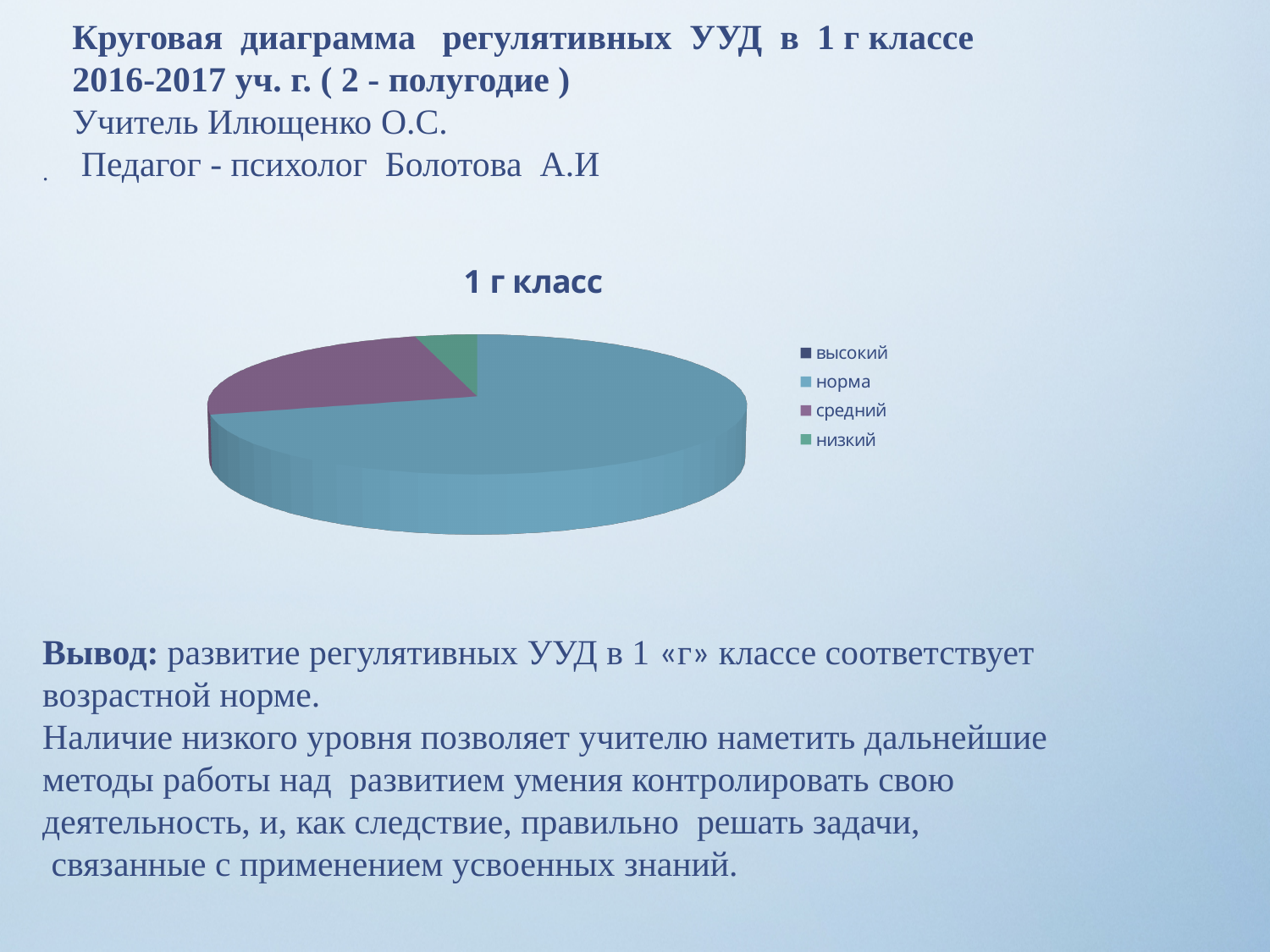
What is the title of the chart? 1 г класс Which slice is larger, норма or средний? норма Is the share of the низкий slice greater or less than 25%? less Which slice is larger, средний or низкий? средний How many entries does the chart legend list? 4 Which slice is larger, норма or низкий? норма What kind of chart is shown on the slide? pie chart Is the share of the норма slice greater or less than 50%? greater Which category has the largest slice of the pie? норма Which legend entry is shown in green? низкий